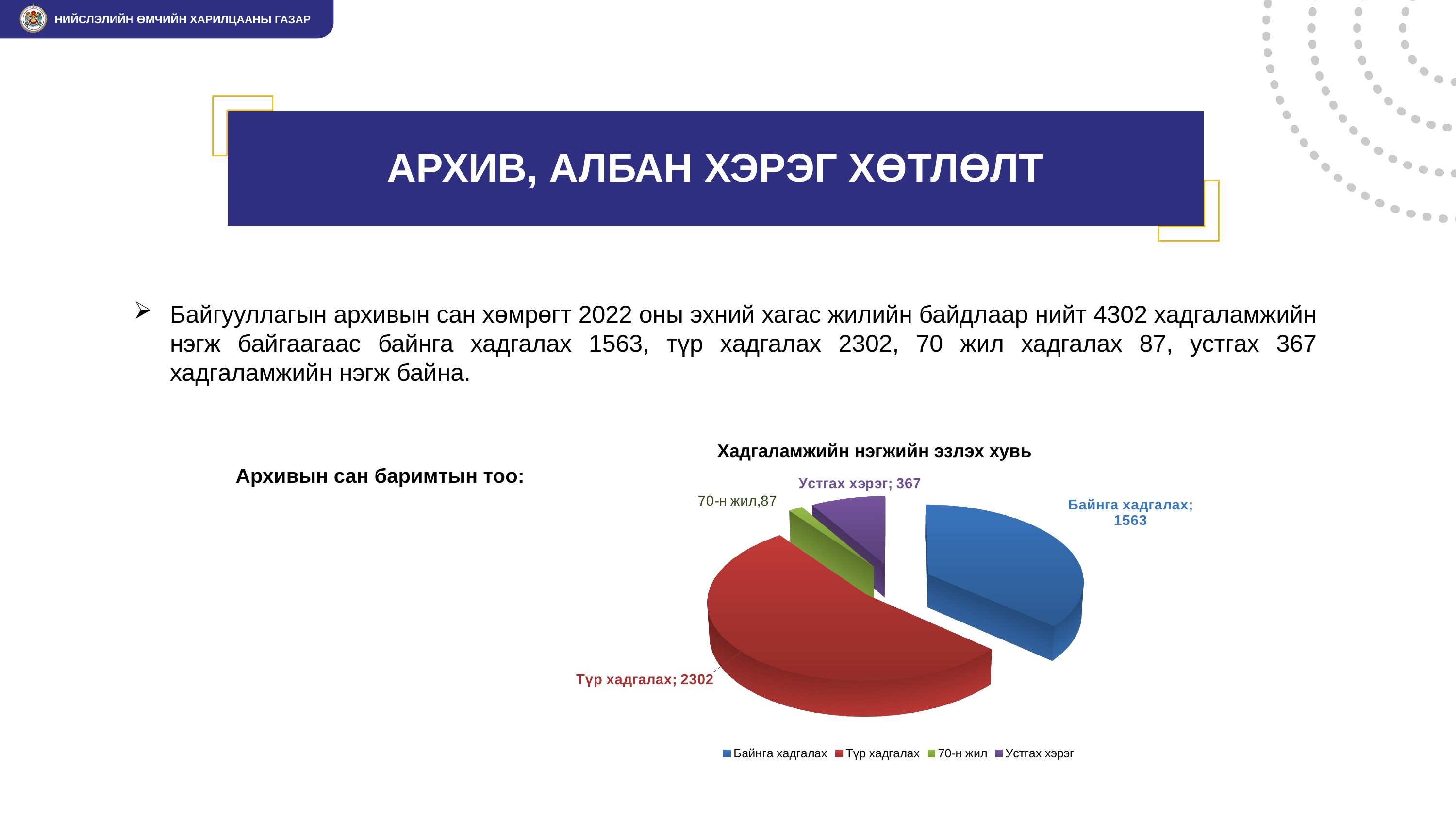
Which category has the largest slice in the pie chart? Түр хадгалах What is the value for 70-н жил in the pie chart? 87 What is the value for Устгах хэрэг in the pie chart? 367 What is the value for Түр хадгалах in the pie chart? 2302 What is the difference between the values for Устгах хэрэг and 70-н жил? 280 What is the title of the pie chart? Хадгаламжийн нэгжийн эзлэх хувь How many categories does the pie chart show? 4 What kind of chart is shown on the slide? Pie chart Which is larger, the value for Байнга хадгалах or the value for Устгах хэрэг? Байнга хадгалах What is the value for Байнга хадгалах in the pie chart? 1563 Which category has the smallest slice in the pie chart? 70-н жил What is the difference between the values for Түр хадгалах and Байнга хадгалах? 739